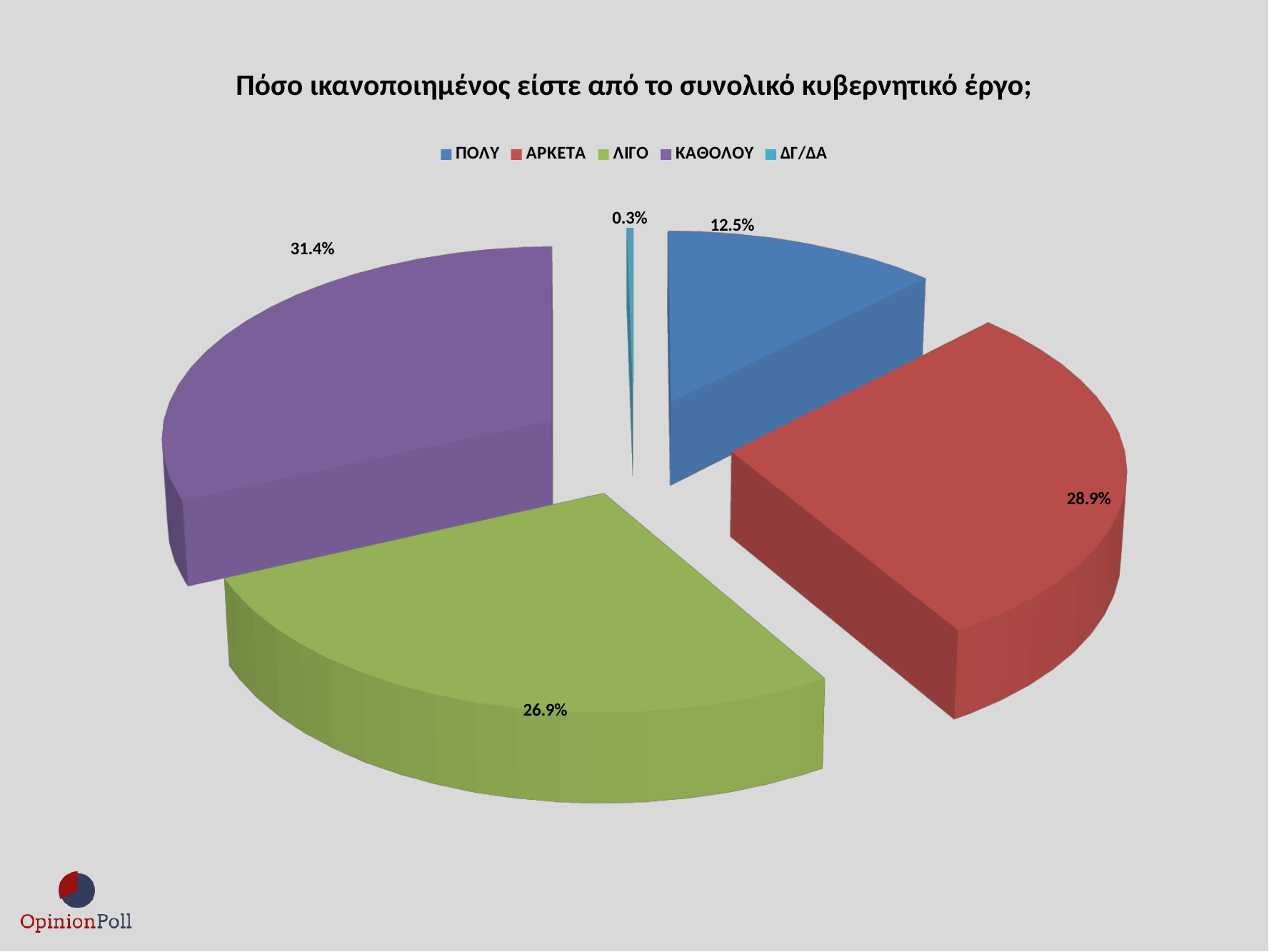
What share of the pie does ΠΟΛΥ have? 12.5% What share of the pie does ΛΙΓΟ have? 26.9% What share of the pie does ΔΓ/ΔΑ have? 0.3% How many categories does the pie chart show? 5 Which category has the largest slice of the pie? ΚΑΘΟΛΟΥ What share of the pie does ΑΡΚΕΤΑ have? 28.9% Which is larger, ΑΡΚΕΤΑ or ΛΙΓΟ? ΑΡΚΕΤΑ What is the difference in percentage points between ΚΑΘΟΛΟΥ and ΠΟΛΥ? 18.9 What colour is the slice for ΛΙΓΟ? Green Which category has the smallest slice of the pie? ΔΓ/ΔΑ What kind of chart is shown on the slide? Pie chart What share of the pie does ΚΑΘΟΛΟΥ have? 31.4%